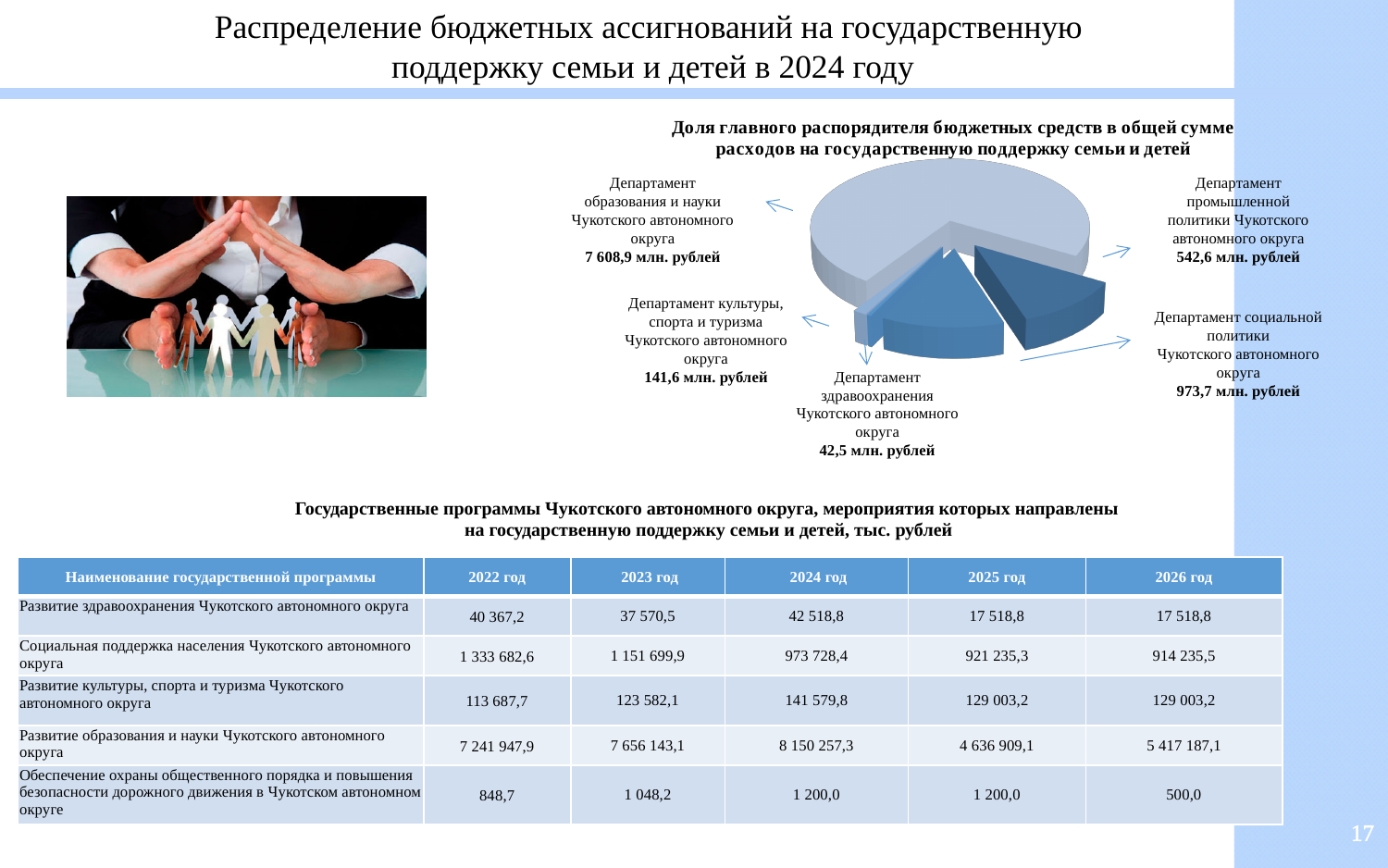
Какое значение на круговой диаграмме указано для Департамента социальной политики Чукотского автономного округа? 973,7 млн. рублей Сколько секторов (главных распорядителей) показано на круговой диаграмме? 5 На сколько млн. рублей значение Департамента образования и науки на круговой диаграмме больше значения Департамента социальной политики? 6 635,2 млн. рублей Что больше на круговой диаграмме: значение Департамента культуры, спорта и туризма или Департамента здравоохранения? Департамент культуры, спорта и туризма Какое значение на круговой диаграмме указано для Департамента культуры, спорта и туризма Чукотского автономного округа? 141,6 млн. рублей Какой тип диаграммы показан на слайде под заголовком «Доля главного распорядителя бюджетных средств в общей сумме расходов на государственную поддержку семьи и детей»? Круговая диаграмма Какой главный распорядитель имеет наименьшую долю на круговой диаграмме? Департамент здравоохранения Чукотского автономного округа Какое значение на круговой диаграмме указано для Департамента образования и науки Чукотского автономного округа? 7 608,9 млн. рублей Какое значение на круговой диаграмме указано для Департамента здравоохранения Чукотского автономного округа? 42,5 млн. рублей На сколько млн. рублей значение Департамента социальной политики на круговой диаграмме больше значения Департамента промышленной политики? 431,1 млн. рублей Какое значение на круговой диаграмме указано для Департамента промышленной политики Чукотского автономного округа? 542,6 млн. рублей Какой главный распорядитель имеет наибольшую долю на круговой диаграмме? Департамент образования и науки Чукотского автономного округа